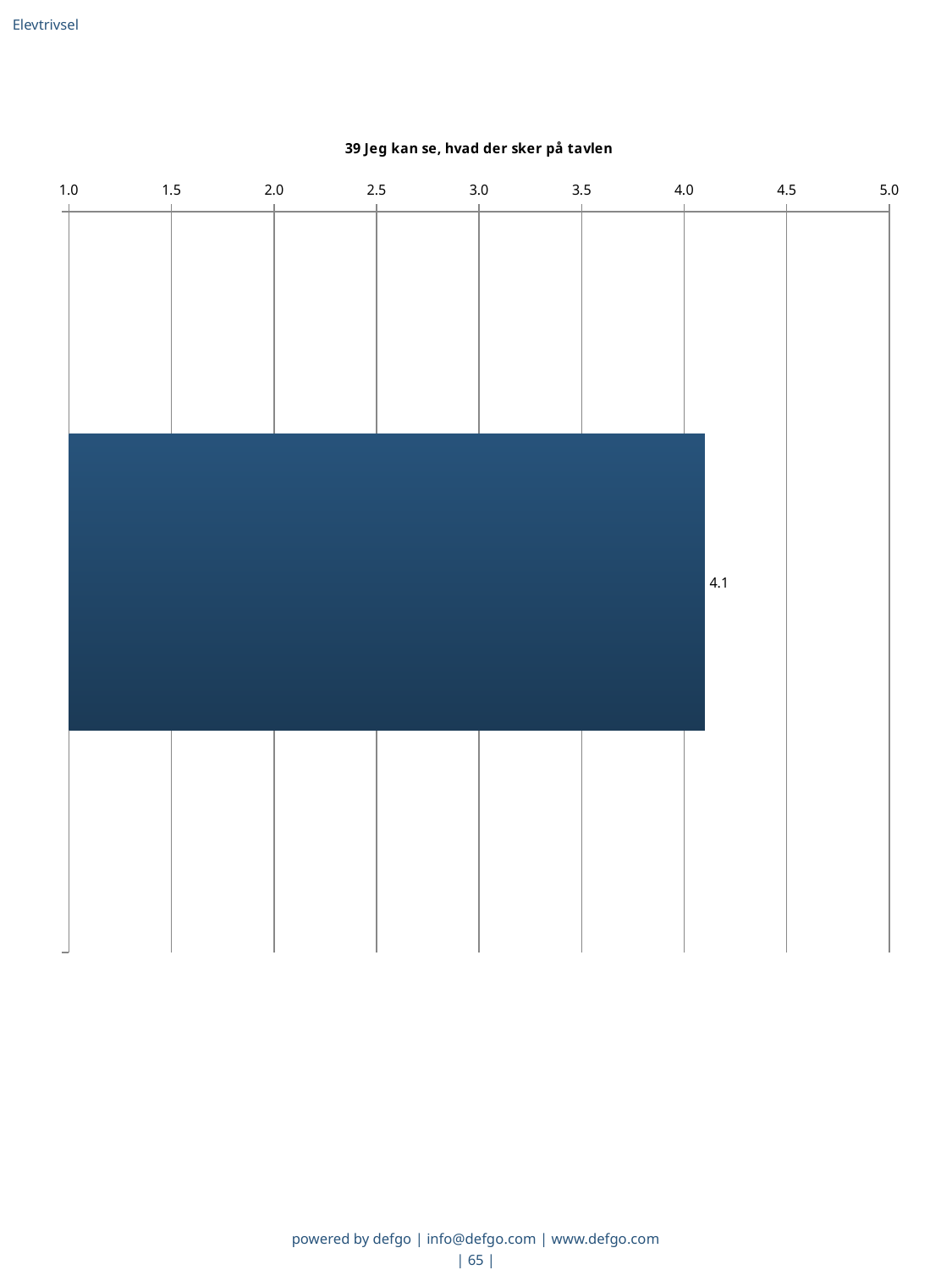
What is the value shown by the bar in the chart? 4.1 Is the bar in the chart horizontal or vertical? horizontal Is the value of the bar greater or less than 4.0? greater What is the title of the chart? 39 Jeg kan se, hvad der sker på tavlen What kind of chart is shown on the slide? bar chart Is the value of the bar greater or less than 4.5? less What is the lowest value shown on the chart's axis? 1.0 How many bars are plotted in the chart? 1